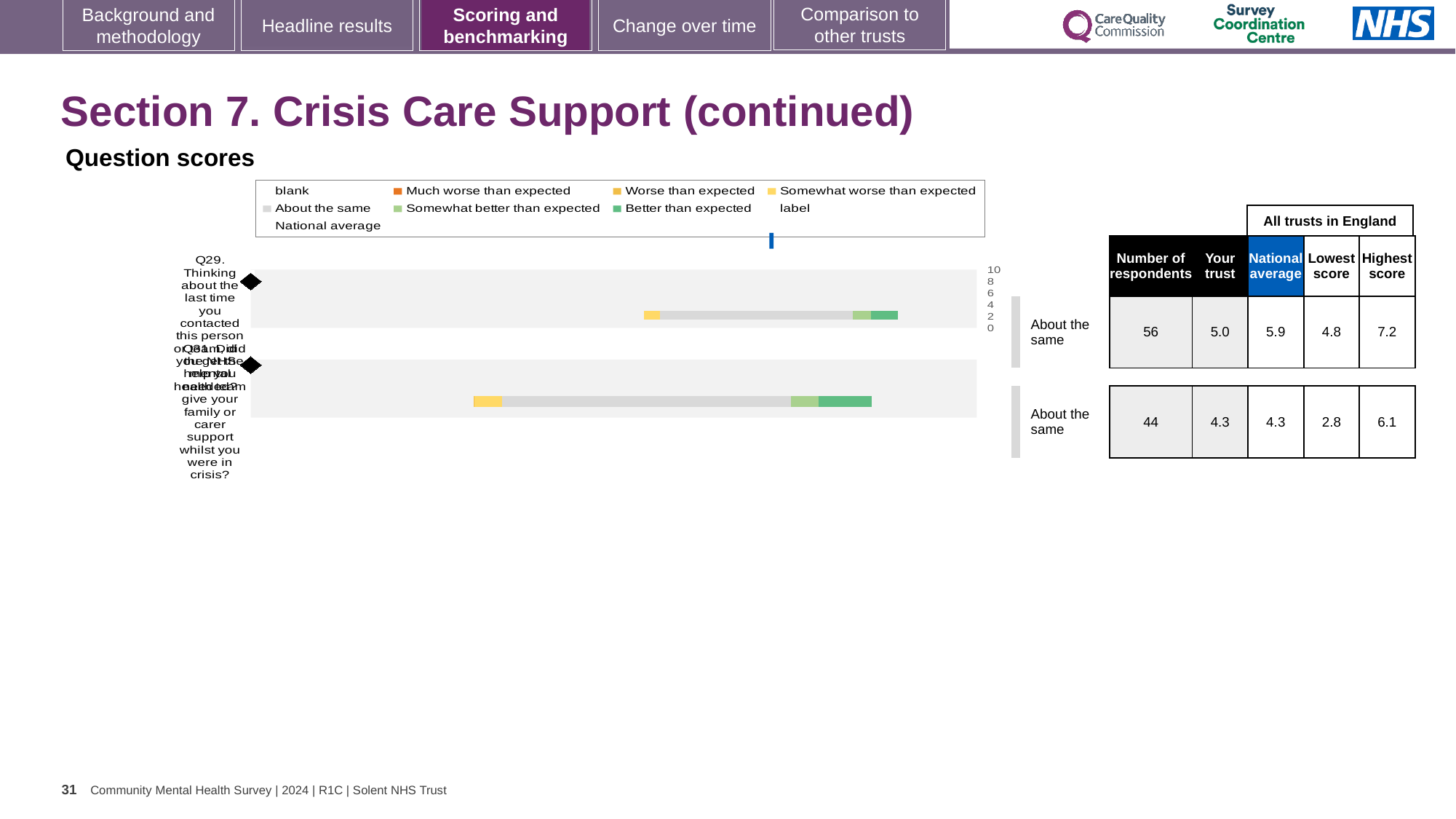
What is the number of respondents for Q31? 44 What is the difference between the highest score and the lowest score for Q31? 3.3 What is the number of respondents for Q29? 56 How many questions are plotted in the question scores chart? 2 Which is larger for Q29, the 'Your trust' score or the national average? National average What is the highest score among all trusts in England for Q29? 7.2 What is the national average for Q29? 5.9 What is the lowest score among all trusts in England for Q31? 2.8 How is the trust's result for Q29 categorised relative to expectations? About the same What is the 'Your trust' score for Q29? 5.0 Which question has more respondents, Q29 or Q31? Q29 What kind of chart is used to show the question scores on this slide? bar chart